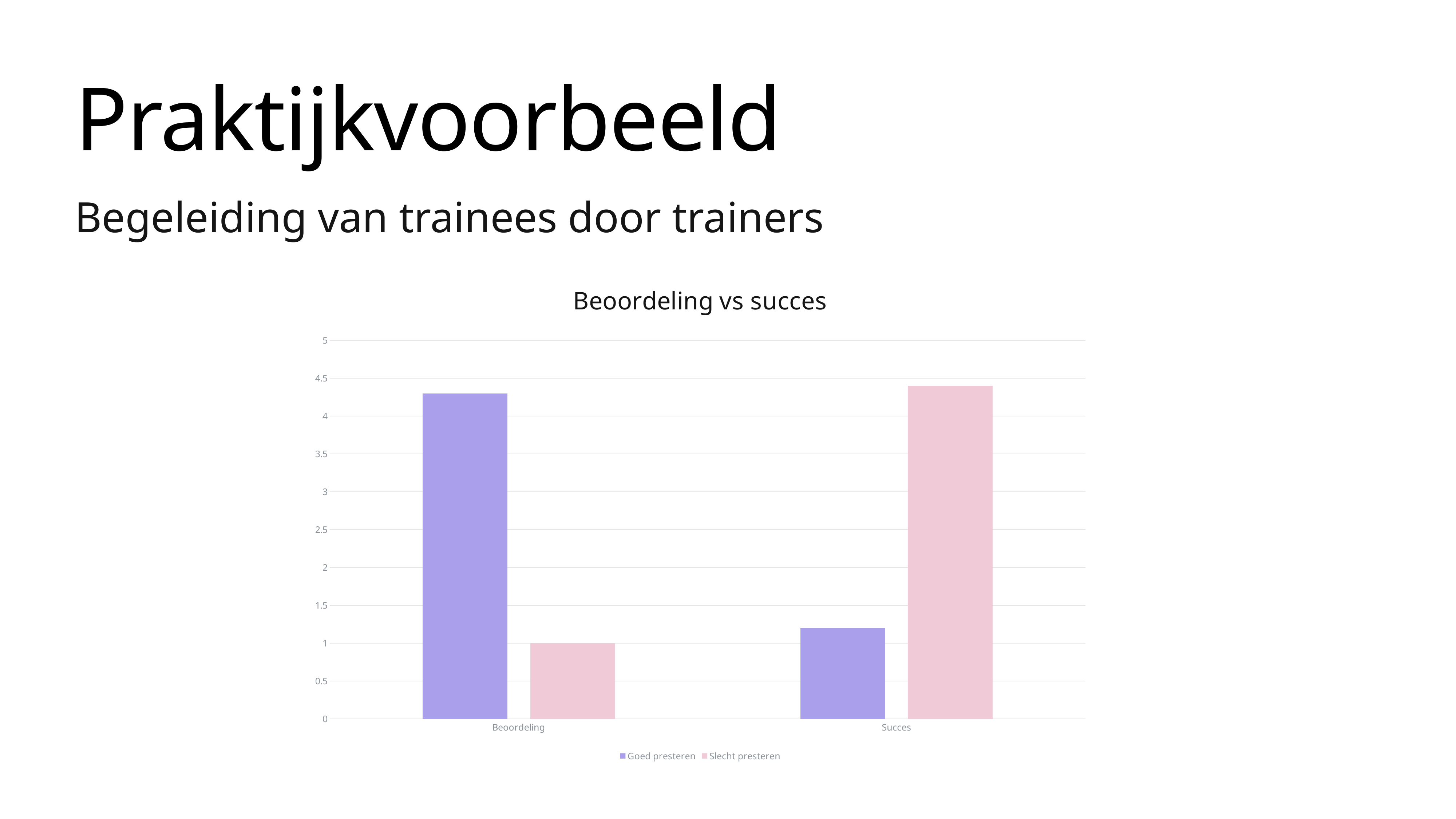
How many categories are shown on the x axis? 2 In the Beoordeling category, which series has the larger value, Goed presteren or Slecht presteren? Goed presteren Which series is shown in pink in the legend? Slecht presteren Is the value for Slecht presteren in the Succes category greater or less than 4? greater Is the value for Goed presteren in the Succes category greater or less than 1.5? less What is the value for Slecht presteren in the Beoordeling category? 1 Is the value for Goed presteren in the Beoordeling category greater or less than 4? greater What is the title of the chart? Beoordeling vs succes What kind of chart is shown on the slide? bar chart How many series does the legend list? 2 Which category has the lowest value for the Goed presteren series? Succes In the Succes category, which series has the larger value, Goed presteren or Slecht presteren? Slecht presteren